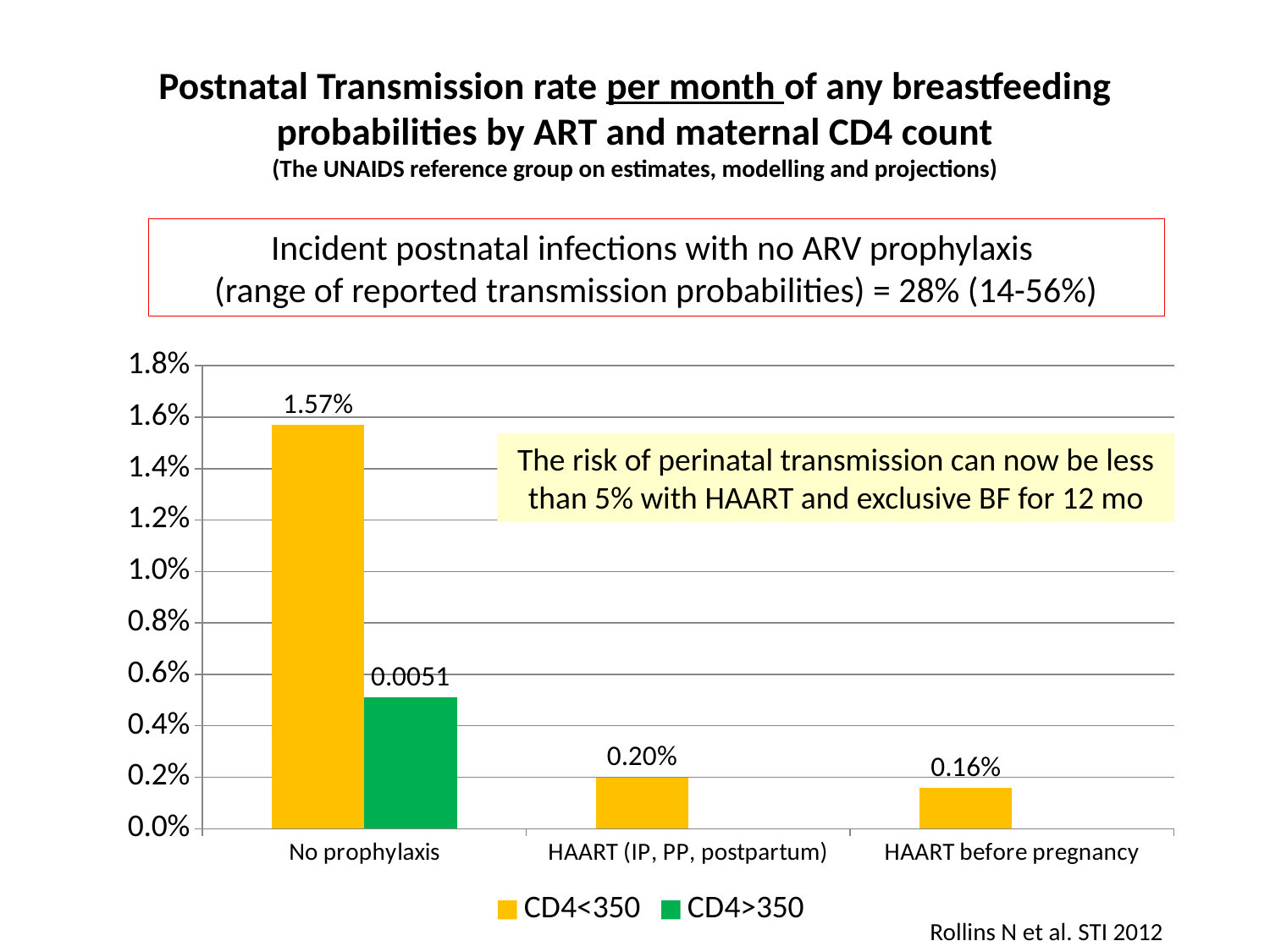
How many series does the legend list? 2 Which category has the lowest CD4<350 value? HAART before pregnancy Is the CD4>350 value for No prophylaxis greater or less than 0.6%? less What is the value for CD4<350 in the HAART before pregnancy category? 0.16% How many categories are shown on the x axis? 3 What is the difference between the CD4<350 values for No prophylaxis and HAART (IP, PP, postpartum)? 1.37% Which is larger for No prophylaxis: the CD4<350 bar or the CD4>350 bar? CD4<350 Which category has the highest CD4<350 value? No prophylaxis What is the value for CD4<350 in the HAART (IP, PP, postpartum) category? 0.20% What is the data label shown on the CD4>350 bar for No prophylaxis? 0.0051 What kind of chart is shown on the slide? bar chart What is the value for CD4<350 in the No prophylaxis category? 1.57%